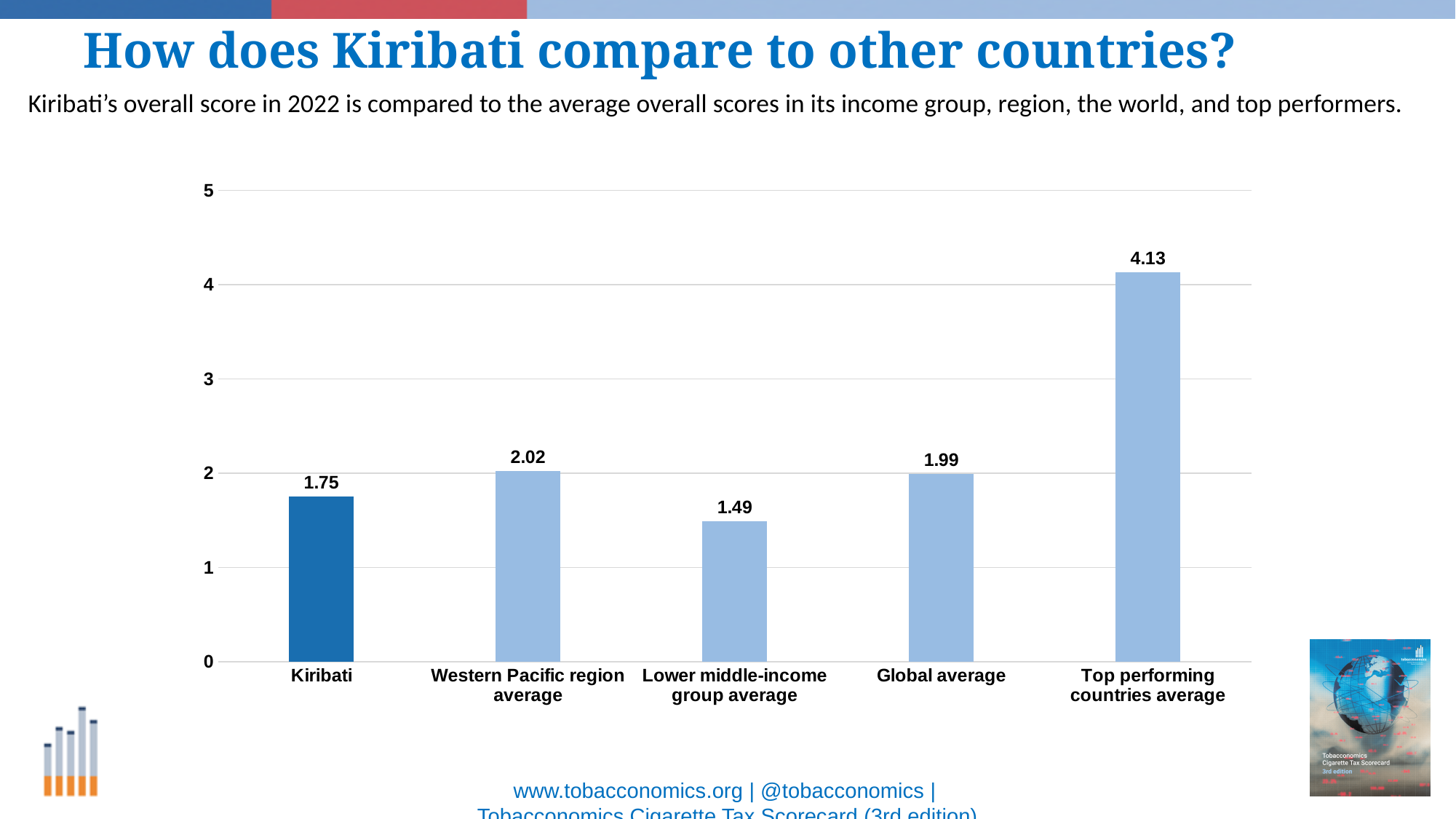
What is the value for the Top performing countries average? 4.13 What kind of chart is shown on the slide? Bar chart Which bar is shown in a darker blue than the others? Kiribati What is the value for the Global average? 1.99 What is the overall score for Kiribati? 1.75 What is the value for the Lower middle-income group average? 1.49 What is the value for the Western Pacific region average? 2.02 Which category has the highest value? Top performing countries average Which is larger, Kiribati's score or the Global average? Global average What is the difference between the Top performing countries average and Kiribati's score? 2.38 How many categories are shown on the chart? 5 Which category has the lowest value? Lower middle-income group average